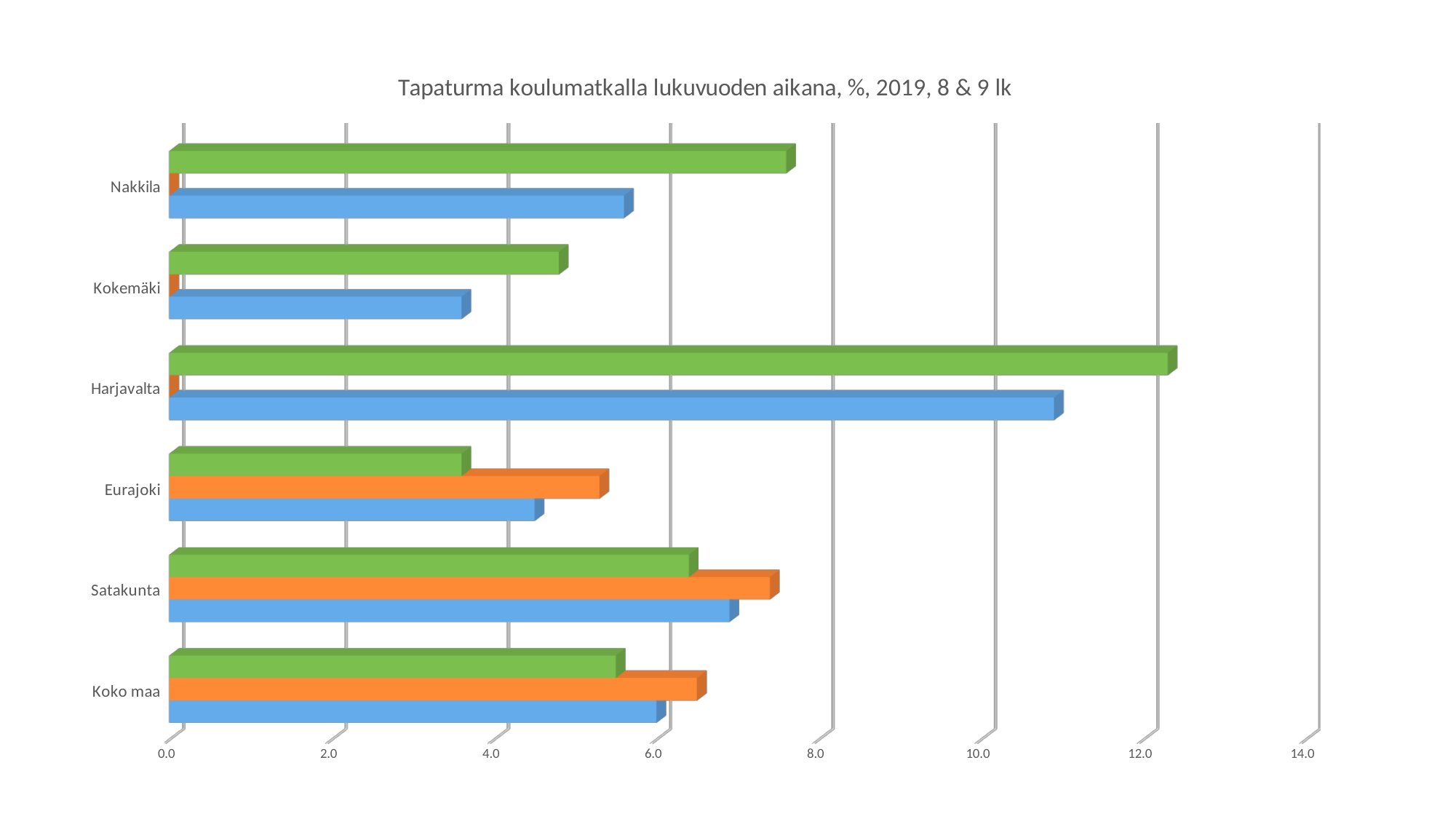
For Nakkila, which bar is longer, the green bar or the blue bar? green How many categories are shown on the vertical axis of the chart? 6 Which category has the shortest blue bar? Kokemäki Is the value of the green bar for Nakkila greater or less than 8.0? less Is the value of the blue bar for Harjavalta greater or less than 10.0? greater Which category has the longest green bar? Harjavalta What is the title of the chart? Tapaturma koulumatkalla lukuvuoden aikana, %, 2019, 8 & 9 lk How many bars are shown for Eurajoki? 3 Which category has the shortest green bar? Eurajoki For Eurajoki, which bar is longer, the orange bar or the green bar? orange What kind of chart is shown on the slide? bar chart Is the value of the blue bar for Kokemäki greater or less than 4.0? less